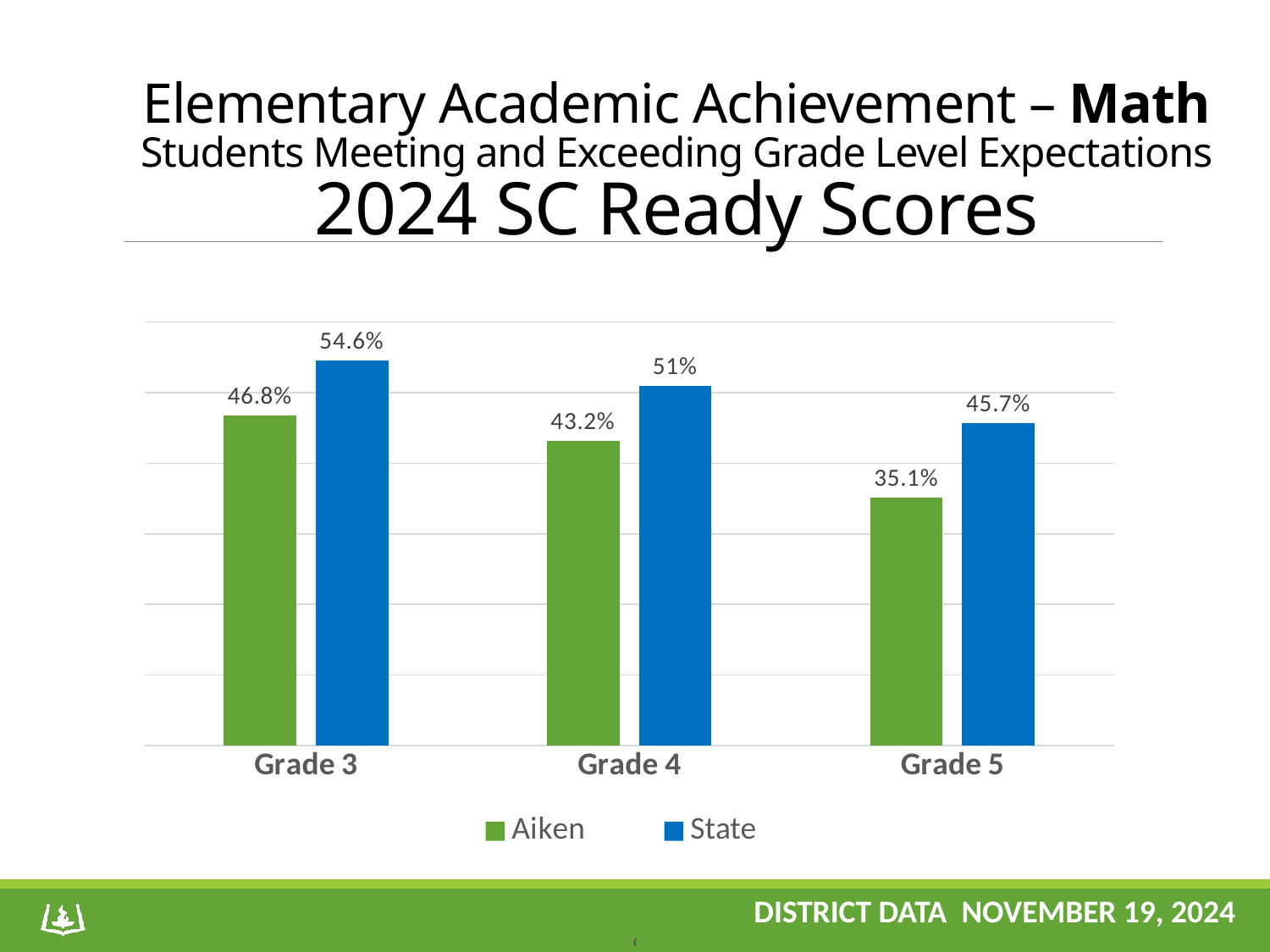
What is the Aiken value for Grade 5? 35.1% What kind of chart is shown on the slide? Bar chart How many grade categories are shown on the x axis? 3 What is the difference between the State and Aiken values for Grade 5? 10.6% Which grade has the highest State value? Grade 3 What is the difference between the State and Aiken values for Grade 3? 7.8% Which is larger for Grade 4, the Aiken value or the State value? State Do the Aiken values rise or fall from Grade 3 to Grade 5? Fall How many series does the legend list? 2 What is the Aiken value for Grade 3? 46.8% Which grade has the lowest Aiken value? Grade 5 What is the State value for Grade 4? 51%